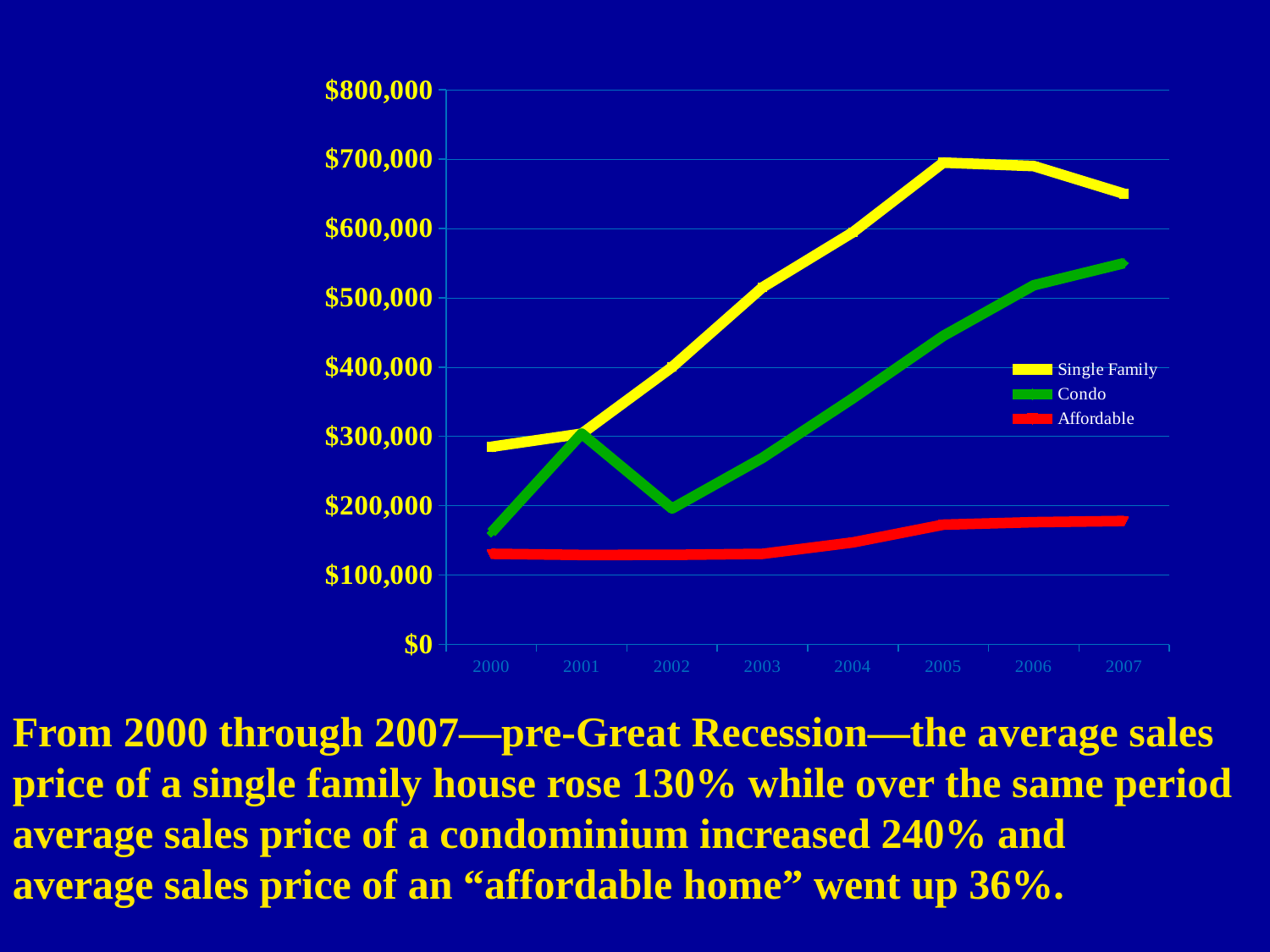
Is the Condo value for 2002 greater or less than $300,000? less What kind of chart is shown on the slide? line chart In which year is the Condo value lowest? 2000 How many years are plotted along the x axis? 8 Is the Single Family value for 2005 greater or less than $600,000? greater What colour is the Single Family line? yellow Is the Affordable value for 2007 greater or less than $200,000? less How many series does the legend list? 3 Does the Affordable series rise or fall from 2000 to 2007? rise Which series has the lowest values across all years? Affordable In 2007, which is larger, the Condo value or the Affordable value? Condo